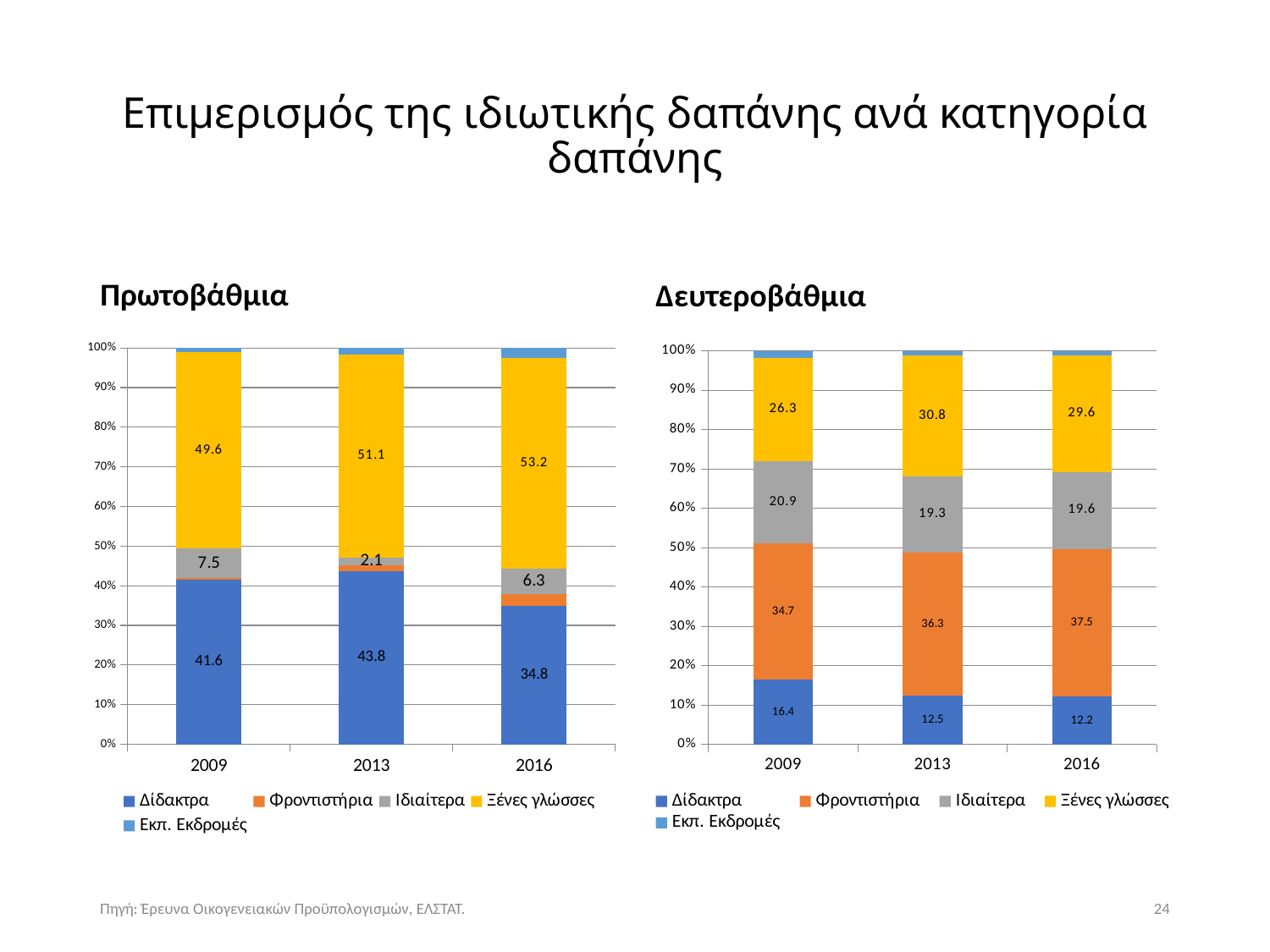
In the Πρωτοβάθμια chart, what is the value of Ιδιαίτερα for 2013? 2.1 How many years are shown on the x axis of the Πρωτοβάθμια chart? 3 In the Πρωτοβάθμια chart, what is the difference between the Δίδακτρα values for 2013 and 2016? 9 How many series does the legend of the Δευτεροβάθμια chart list? 5 In the Δευτεροβάθμια chart, what is the value of Δίδακτρα for 2009? 16.4 What kind of chart is the Πρωτοβάθμια chart? stacked bar chart In the Δευτεροβάθμια chart, which year has the lowest value for Ξένες γλώσσες? 2009 In the Δευτεροβάθμια chart, what is the value of Φροντιστήρια for 2013? 36.3 In the Δευτεροβάθμια chart, which is larger for 2016: Ιδιαίτερα or Ξένες γλώσσες? Ξένες γλώσσες In the Πρωτοβάθμια chart, which year has the highest value for Δίδακτρα? 2013 In the Πρωτοβάθμια chart, what is the value of Ξένες γλώσσες for 2016? 53.2 In the Δευτεροβάθμια chart, does the value of Φροντιστήρια rise or fall from 2009 to 2016? rise